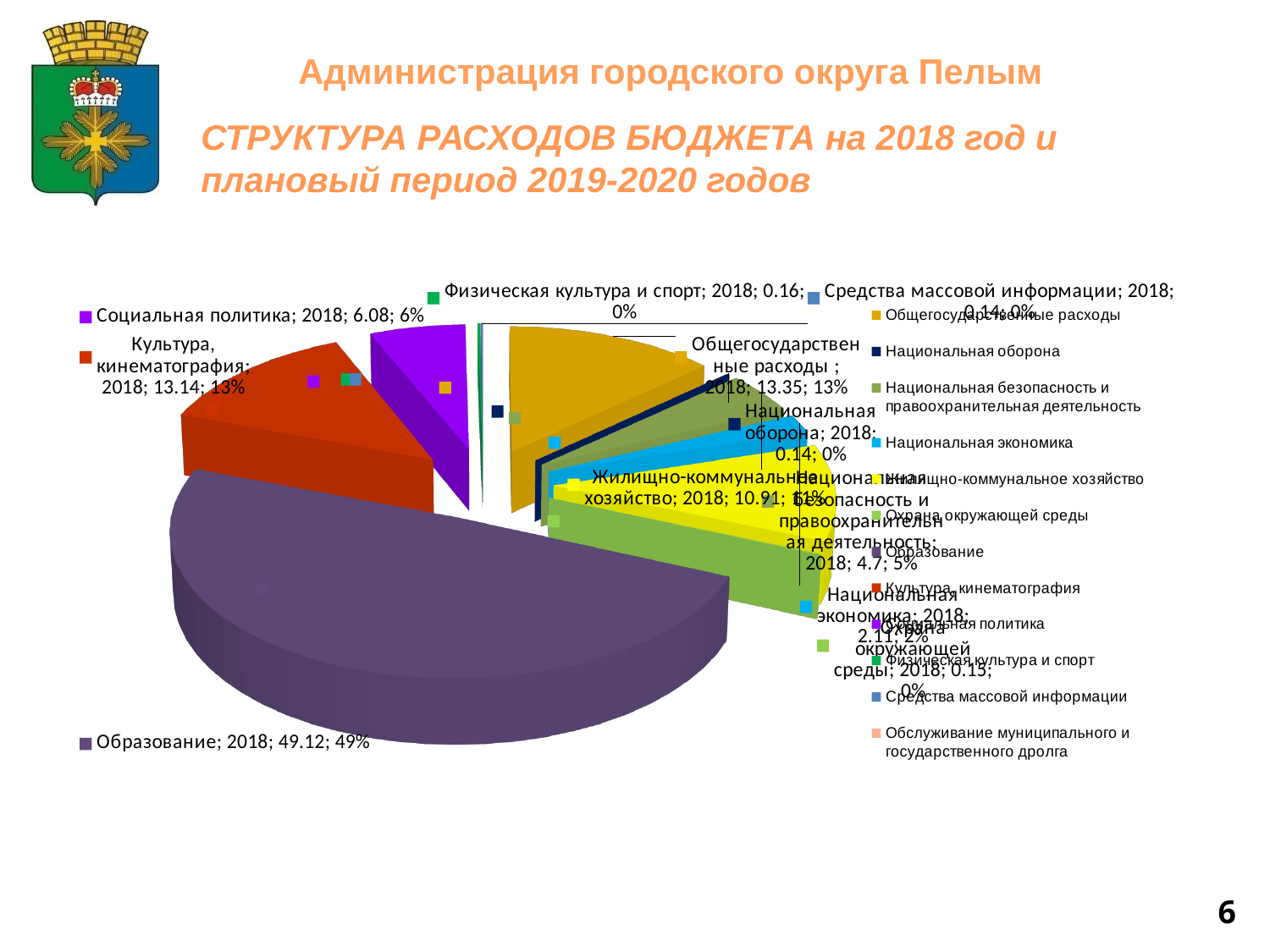
What kind of chart is shown on the slide? Pie chart What value is shown for Общегосударственные расходы in 2018? 13.35 What percentage share does Образование have in the pie? 49% What value is shown for Культура, кинематография in 2018? 13.14 What value is shown for Физическая культура и спорт in 2018? 0.16 Which category has the largest share of the 2018 budget expenditure? Образование What value is shown for Образование in 2018? 49.12 What is the difference between the values for Общегосударственные расходы (13.35) and Культура, кинематография (13.14)? 0.21 Which is larger: the value for Социальная политика or the value for Национальная экономика? Социальная политика How many entries does the legend list? 12 What percentage share does Социальная политика have in the pie? 6% What value is shown for Жилищно-коммунальное хозяйство in 2018? 10.91